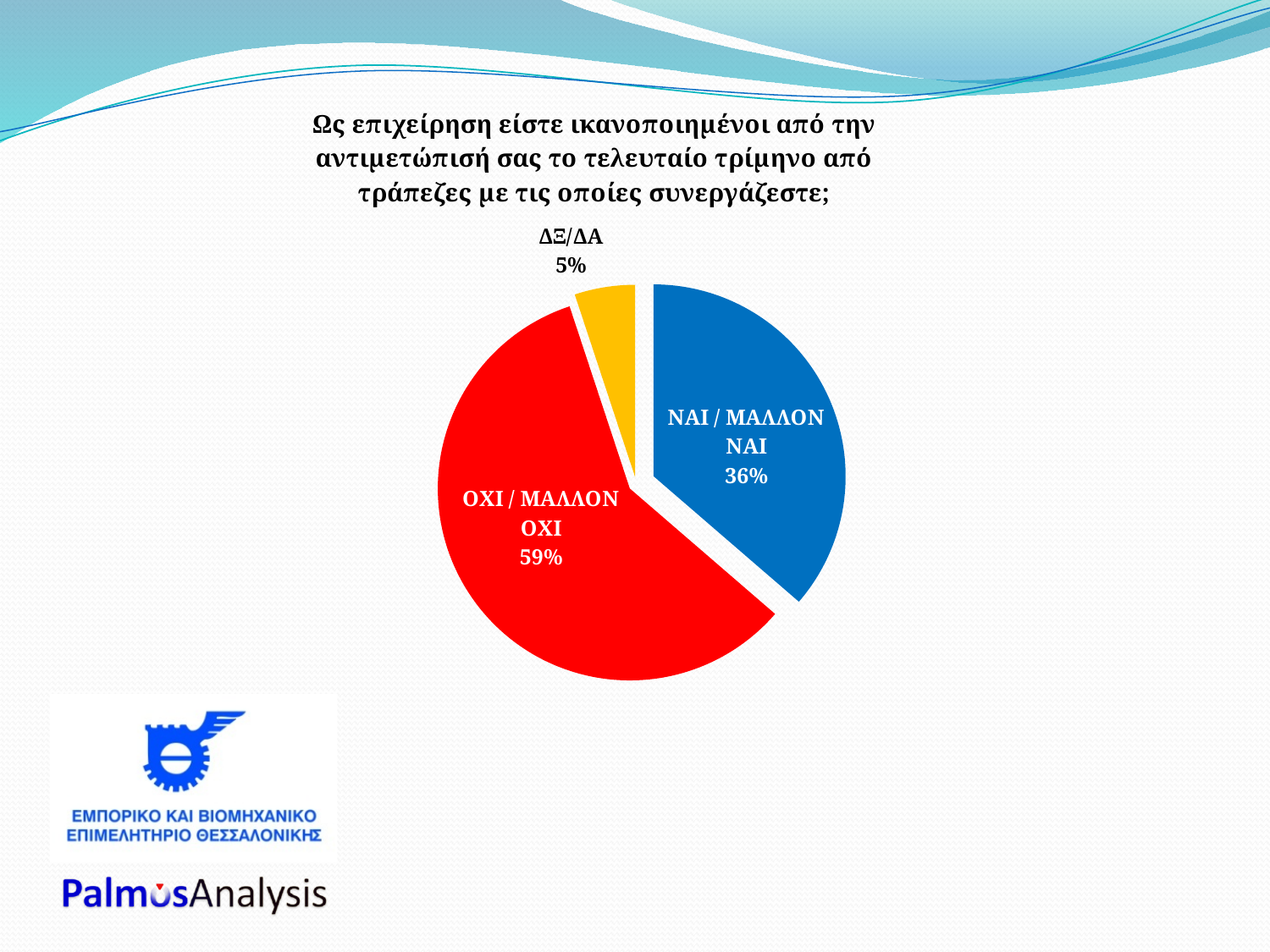
What is the combined share of the ΝΑΙ / ΜΑΛΛΟΝ ΝΑΙ and ΔΞ/ΔΑ slices? 41% What kind of chart is shown on the slide? pie chart What percentage of the pie is the ΔΞ/ΔΑ slice? 5% Which slice of the pie is the smallest? ΔΞ/ΔΑ What percentage of the pie is the ΟΧΙ / ΜΑΛΛΟΝ ΟΧΙ slice? 59% Which is larger, the ΝΑΙ / ΜΑΛΛΟΝ ΝΑΙ slice or the ΔΞ/ΔΑ slice? ΝΑΙ / ΜΑΛΛΟΝ ΝΑΙ What percentage of the pie is the ΝΑΙ / ΜΑΛΛΟΝ ΝΑΙ slice? 36% Which slice of the pie is the largest? ΟΧΙ / ΜΑΛΛΟΝ ΟΧΙ What colour is the ΔΞ/ΔΑ slice? yellow What is the difference in percentage points between the ΟΧΙ / ΜΑΛΛΟΝ ΟΧΙ slice and the ΝΑΙ / ΜΑΛΛΟΝ ΝΑΙ slice? 23 What colour is the ΟΧΙ / ΜΑΛΛΟΝ ΟΧΙ slice? red How many slices does the pie chart have? 3